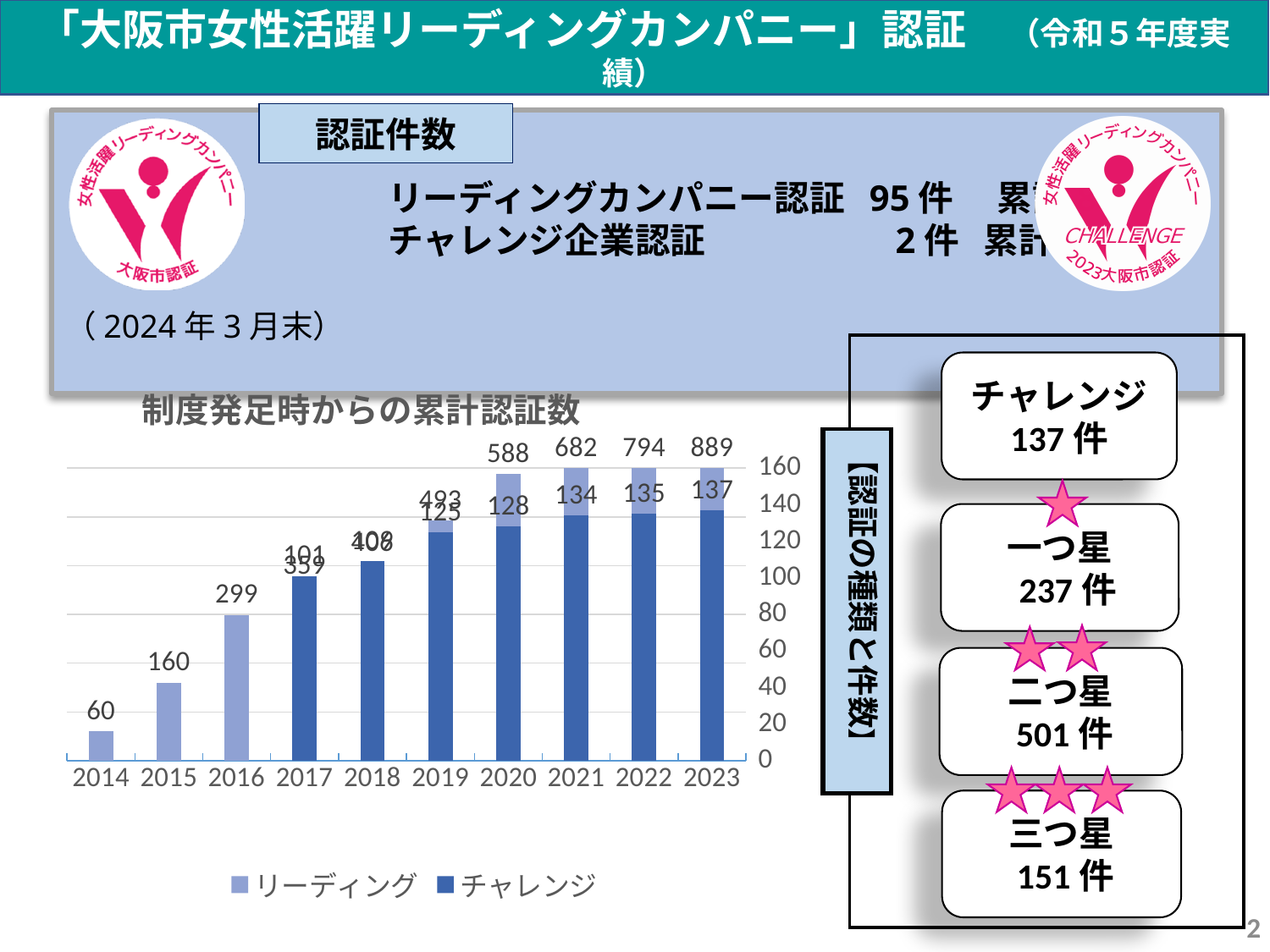
In the 制度発足時からの累計認証数 chart, what is the リーディング value for 2023? 889 What are the two legend entries in the 制度発足時からの累計認証数 chart? リーディング and チャレンジ In the 制度発足時からの累計認証数 chart, which year has the highest リーディング value? 2023 In the 制度発足時からの累計認証数 chart, do the リーディング values rise or fall from 2014 to 2023? rise In the 制度発足時からの累計認証数 chart, which year has the lowest リーディング value? 2014 What is the title of the bar chart on the slide? 制度発足時からの累計認証数 In the 制度発足時からの累計認証数 chart, by how much did the リーディング value increase from 2022 to 2023? 95 How many series does the legend of the 制度発足時からの累計認証数 chart list? 2 In the 制度発足時からの累計認証数 chart, what is the チャレンジ value for 2023? 137 In the 制度発足時からの累計認証数 chart, what is the value labelled for 2014? 60 What kind of chart is used to show 制度発足時からの累計認証数? bar chart How many years are shown on the x axis of the 制度発足時からの累計認証数 chart? 10